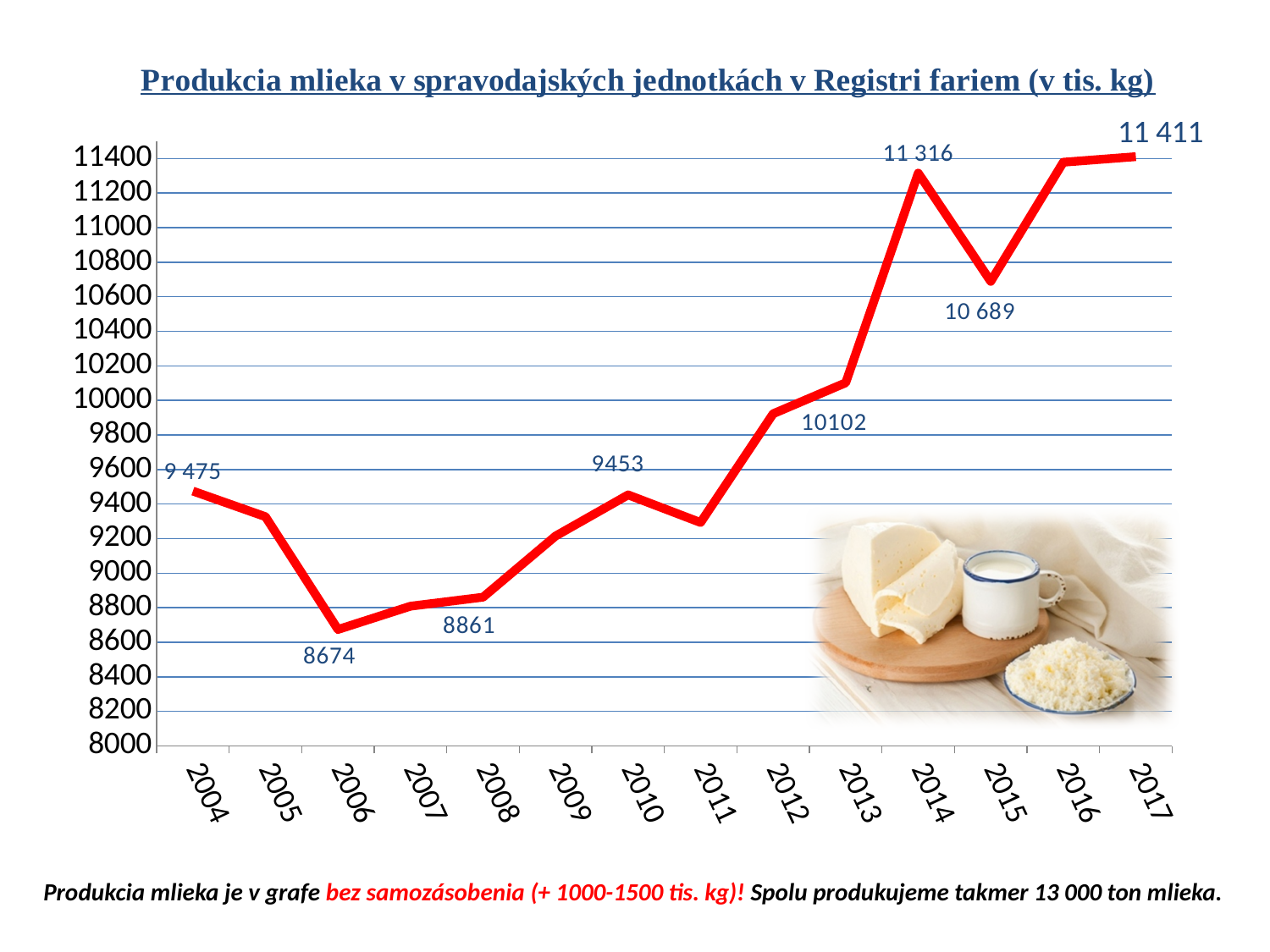
Is the value for 2012 greater or less than 9800? greater What was the milk production value in 2004? 9 475 What is the difference between the values for 2014 and 2015? 627 What value is shown for 2006? 8674 What value is shown for 2017? 11 411 Is the value for 2011 greater or less than 9400? less Which is larger, the value for 2014 or the value for 2017? 2017 How many years are shown on the x axis? 14 Which year has the lowest milk production? 2006 Does the value rise or fall from 2013 to 2014? rise What kind of chart is shown on the slide? line chart What value is shown for 2015? 10 689